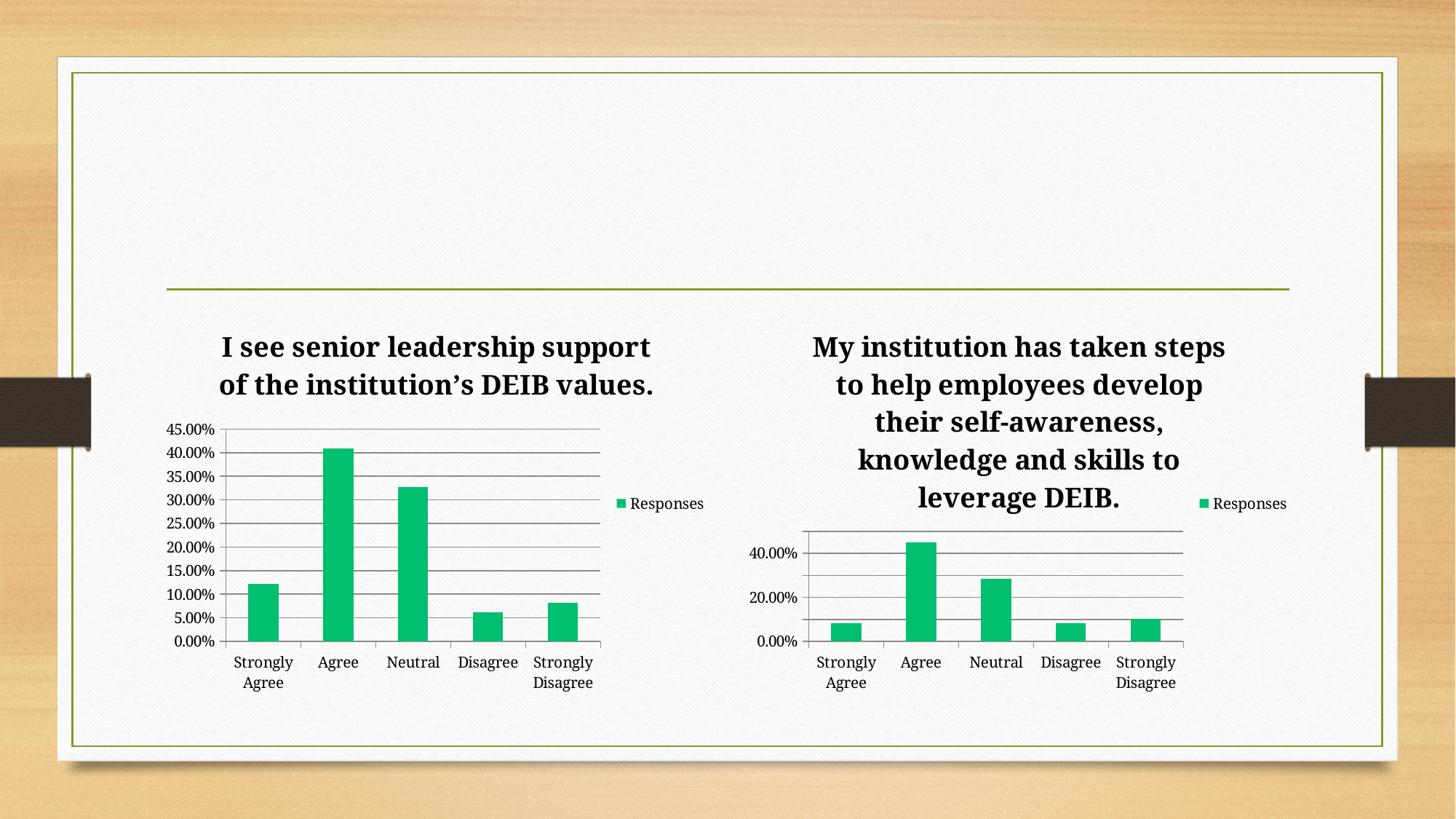
On the left chart, is the value for Agree greater or less than 35.00%? greater On the left chart, is the value for Disagree greater or less than 10.00%? less How many series does the legend of the right chart list? 1 On the chart titled "I see senior leadership support of the institution's DEIB values.", which category has the highest value? Agree On the right chart, which is larger, the value for Neutral or the value for Strongly Disagree? Neutral On the left chart, is the value for Neutral greater or less than 30.00%? greater How many categories are shown on the x axis of the left chart? 5 On the chart titled "My institution has taken steps to help employees develop their self-awareness, knowledge and skills to leverage DEIB.", which category has the highest value? Agree On the left chart, which is larger, the value for Agree or the value for Neutral? Agree What kind of chart is the left chart? Bar chart